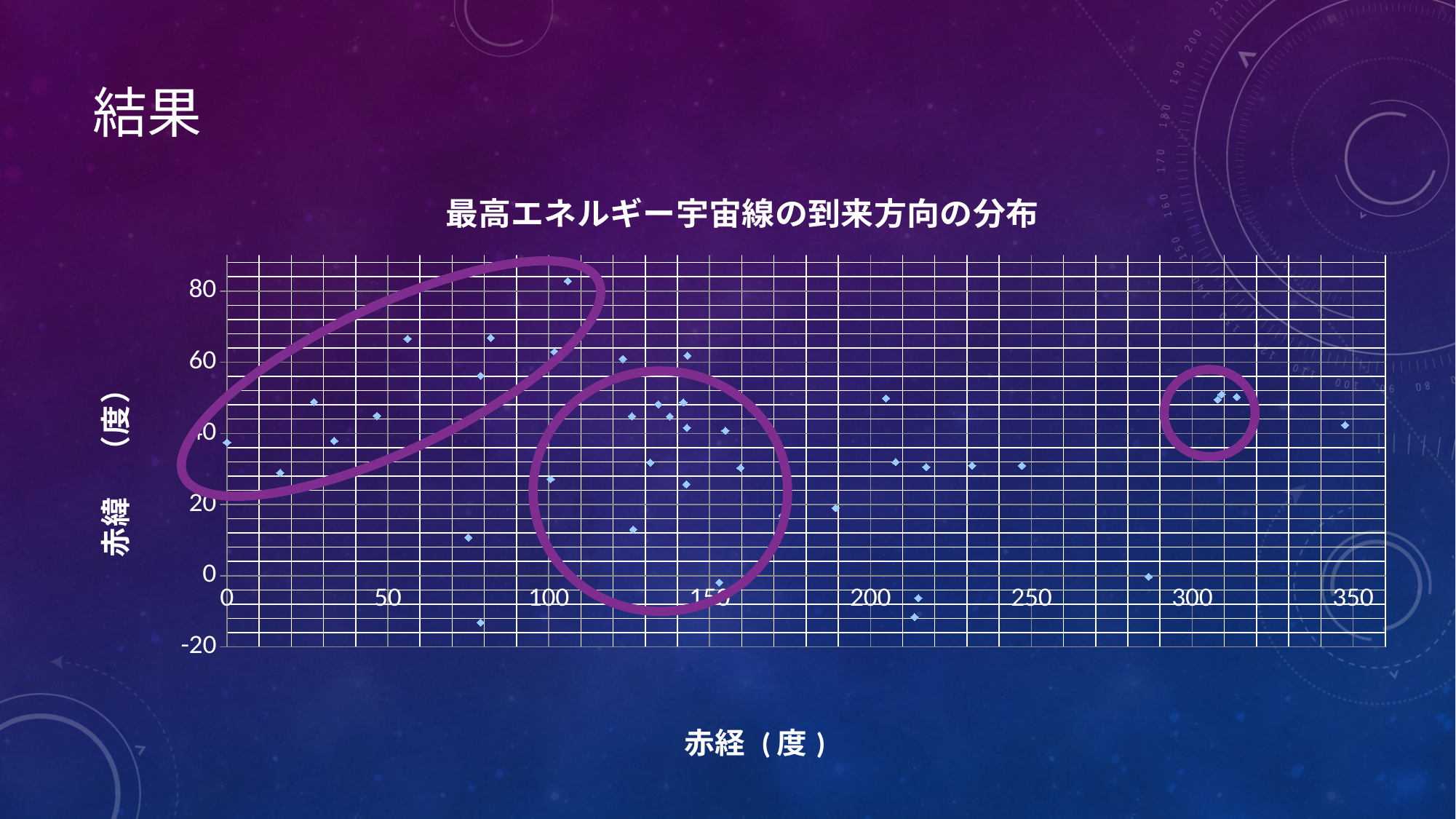
Does the chart show a legend? No What is the lowest value shown on the vertical axis of the chart? -20 Is the vertical-axis value of the lowest point in the chart greater or less than 0? less What is the title of the chart? 最高エネルギー宇宙線の到来方向の分布 What kind of chart is shown on the slide? Scatter chart Is the horizontal-axis value of the highest point in the chart greater or less than 100? greater What is the largest tick value shown on the horizontal axis of the chart? 350 What is the label of the horizontal axis of the chart? 赤経（度） What is the highest value shown on the vertical axis of the chart? 80 Is the vertical-axis value of the highest point in the chart greater or less than 80? greater